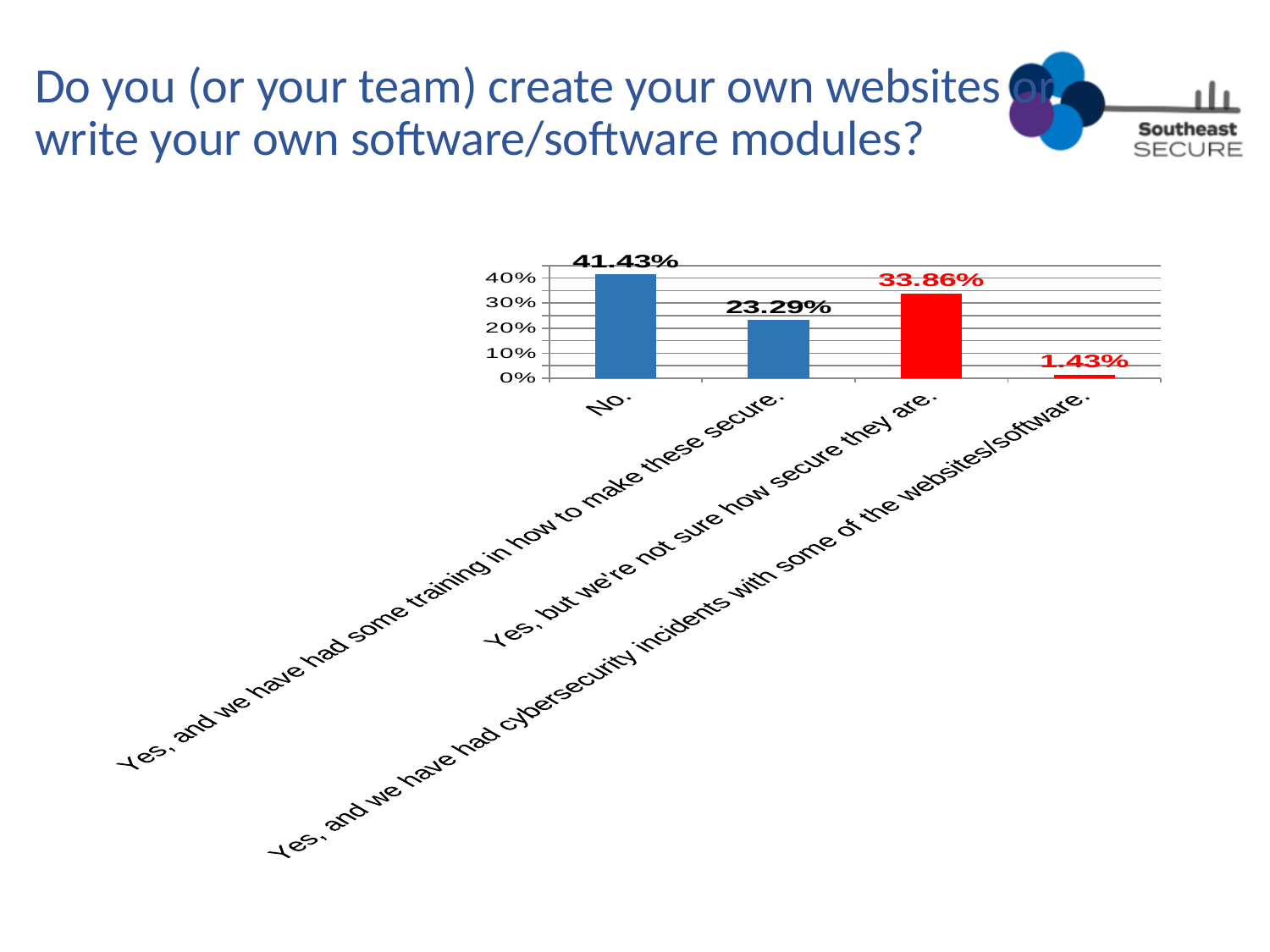
What is the value for "Yes, but we're not sure how secure they are."? 33.86% What percentage of respondents answered "No."? 41.43% What type of chart is shown on the slide? Bar chart Which response has the lowest percentage? Yes, and we have had cybersecurity incidents with some of the websites/software. Which is larger: the value for "Yes, but we're not sure how secure they are." or the value for "Yes, and we have had some training in how to make these secure."? Yes, but we're not sure how secure they are. What is the value for "Yes, and we have had cybersecurity incidents with some of the websites/software."? 1.43% What is the difference between "Yes, but we're not sure how secure they are." and "Yes, and we have had cybersecurity incidents with some of the websites/software."? 32.43% What is the value for "Yes, and we have had some training in how to make these secure."? 23.29% How many response categories are shown in the chart? 4 Which response has the highest percentage? No. What colour are the bars for "Yes, but we're not sure how secure they are." and "Yes, and we have had cybersecurity incidents with some of the websites/software."? Red What is the difference between the "No." value and the "Yes, and we have had some training in how to make these secure." value? 18.14%